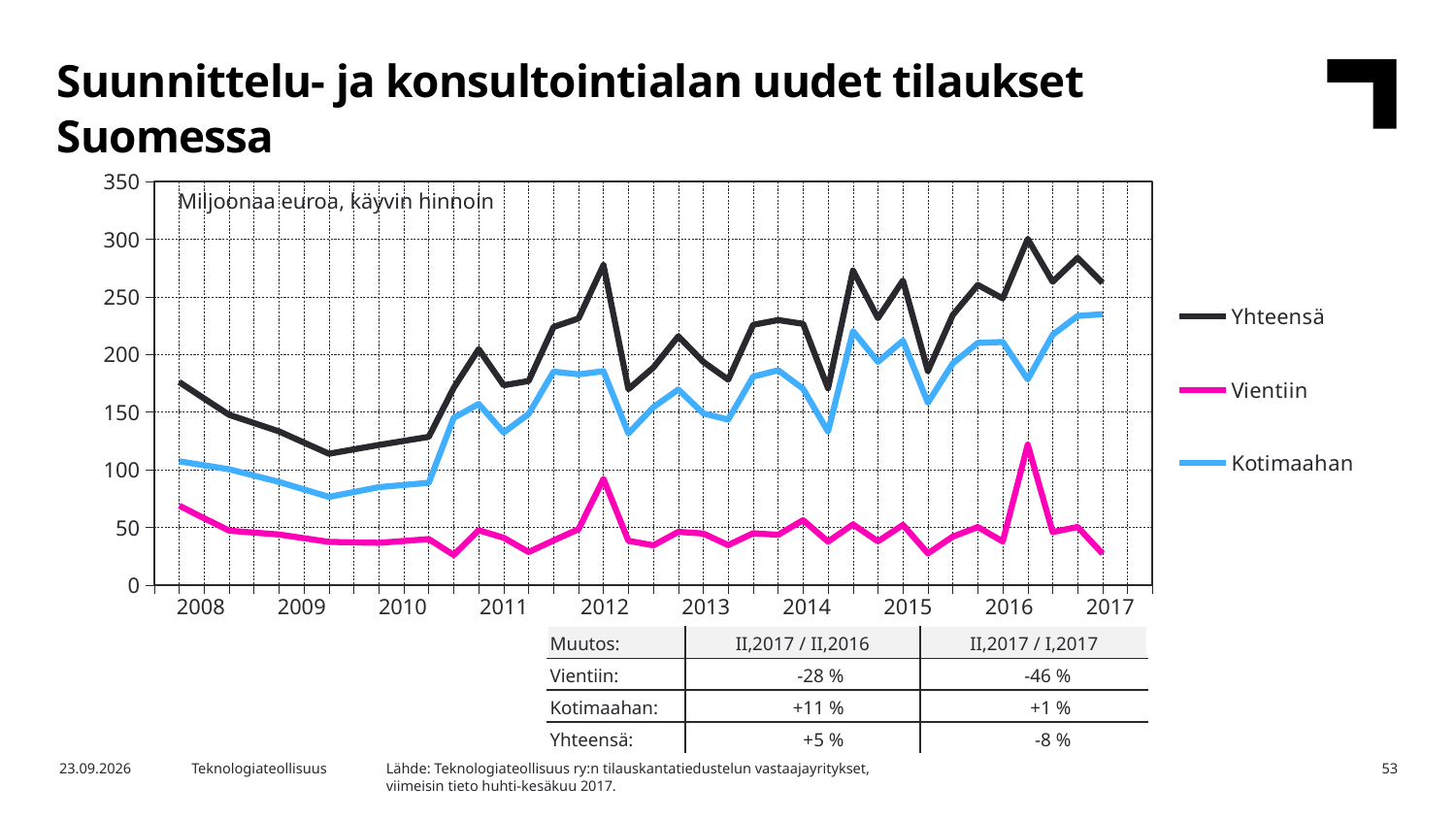
Is the value of Kotimaahan at the end of the series in 2017 greater or less than 200? greater Is the value of Yhteensä at the start of 2008 greater or less than 150? greater What unit is stated inside the chart area? Miljoonaa euroa, käyvin hinnoin Is the peak value of Vientiin in 2016 greater or less than 100? greater How many series does the legend list? 3 Which series has the lowest values throughout the chart? Vientiin How many years are labelled on the x axis? 10 What kind of chart is shown on the slide? line chart Which series has the highest values throughout the chart? Yhteensä Which is larger in 2015, Kotimaahan or Vientiin? Kotimaahan Which series are listed in the legend? Yhteensä, Vientiin, Kotimaahan Does the Yhteensä series rise or fall from 2008 to 2009? fall